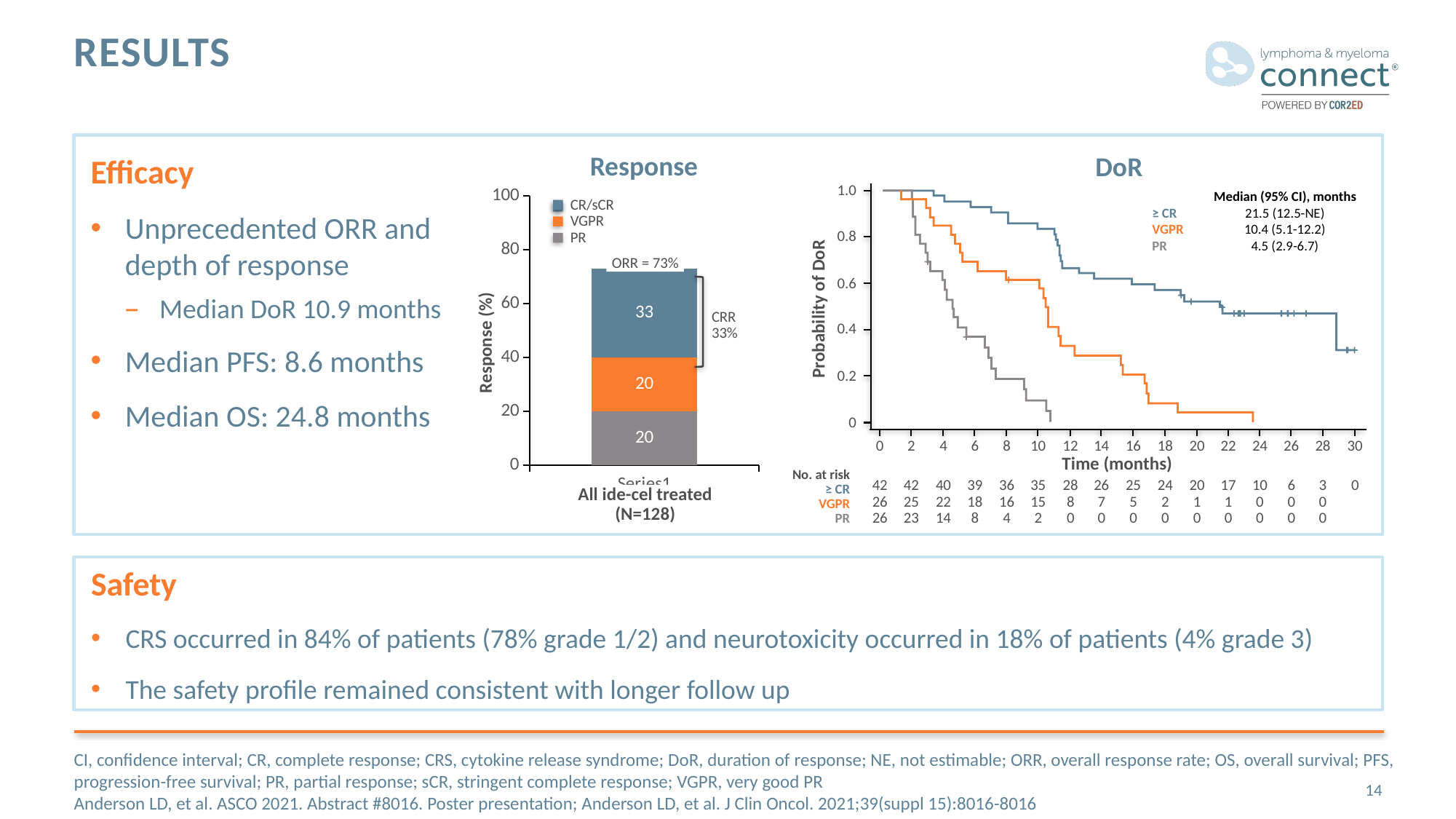
In the DoR chart, what is the median (95% CI) duration of response in months for the VGPR group? 10.4 (5.1-12.2) In the Response chart, which response category has the largest segment? CR/sCR In the Response chart, what is the value of the CR/sCR segment? 33 In the Response chart, how many series does the legend list? 3 In the DoR chart, how many ≥ CR patients are at risk at 0 months? 42 In the Response chart, what is the difference between the CR/sCR and PR segments? 13 In the Response chart, what is the total of the stacked bar for all ide-cel treated patients? 73 In the DoR chart, which response group has the highest median duration of response? ≥ CR In the Response chart, what is the value of the VGPR segment? 20 What kind of chart is the Response chart? Stacked bar chart What kind of chart is the DoR chart? Line chart (Kaplan-Meier curve) In the DoR chart, do the probability curves rise or fall as time increases? Fall